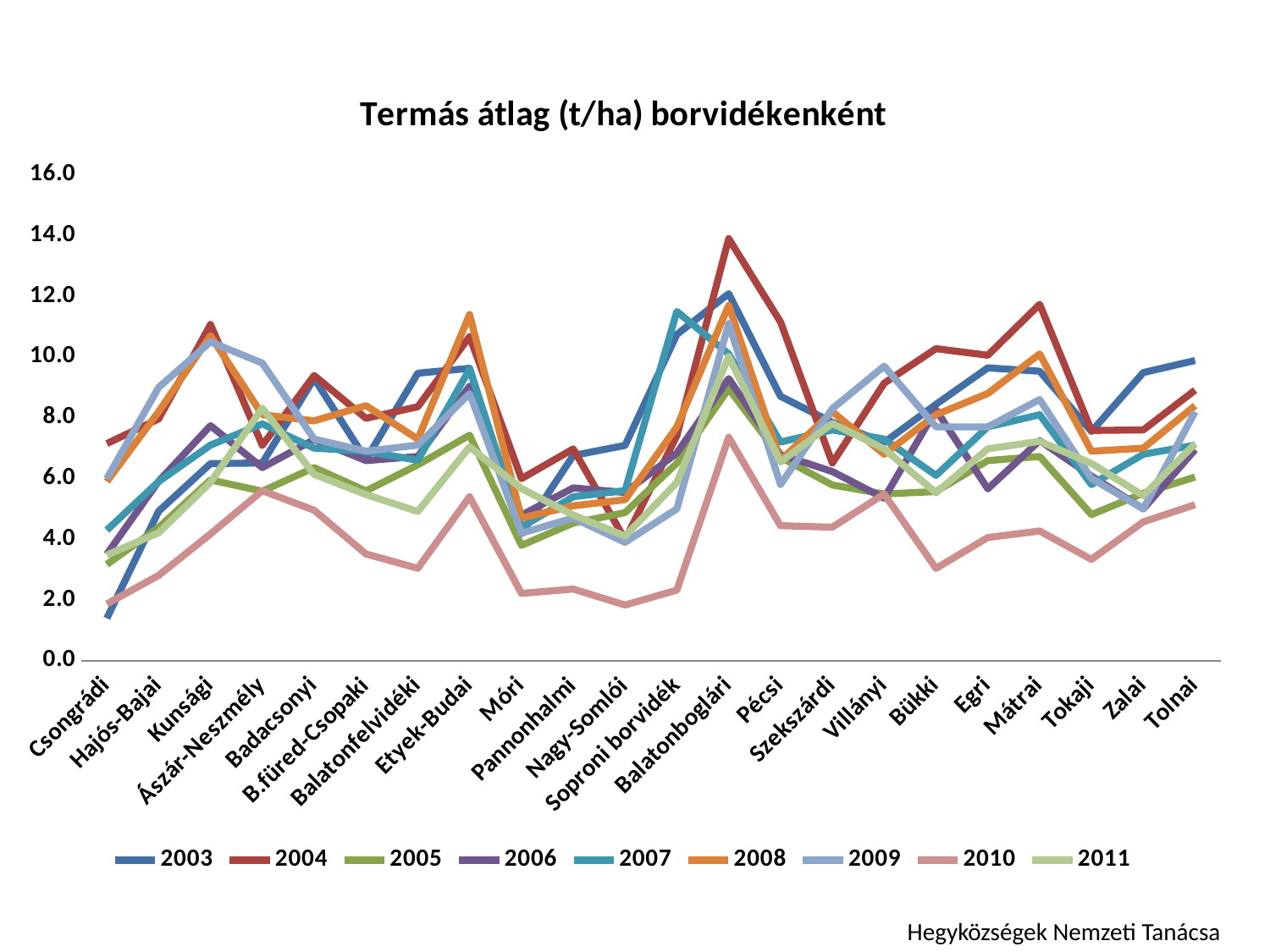
Is the value for 2007 at Soproni borvidék greater or less than 10.0? greater How many wine regions (categories) are shown on the x axis? 22 At Balatonboglári, which is larger: the value for 2004 or the value for 2010? 2004 For the 2003 series, which wine region has the lowest value? Csongrádi How many series does the legend list? 9 Is the value for 2003 at Csongrádi greater or less than 2.0? less Is the value for 2010 at Balatonboglári greater or less than 6.0? greater What is the title of the chart? Termás átlag (t/ha) borvidékenként Which source is credited at the bottom of the slide? Hegyközségek Nemzeti Tanácsa For the 2004 series, which wine region has the highest value? Balatonboglári What kind of chart is shown on the slide? line chart